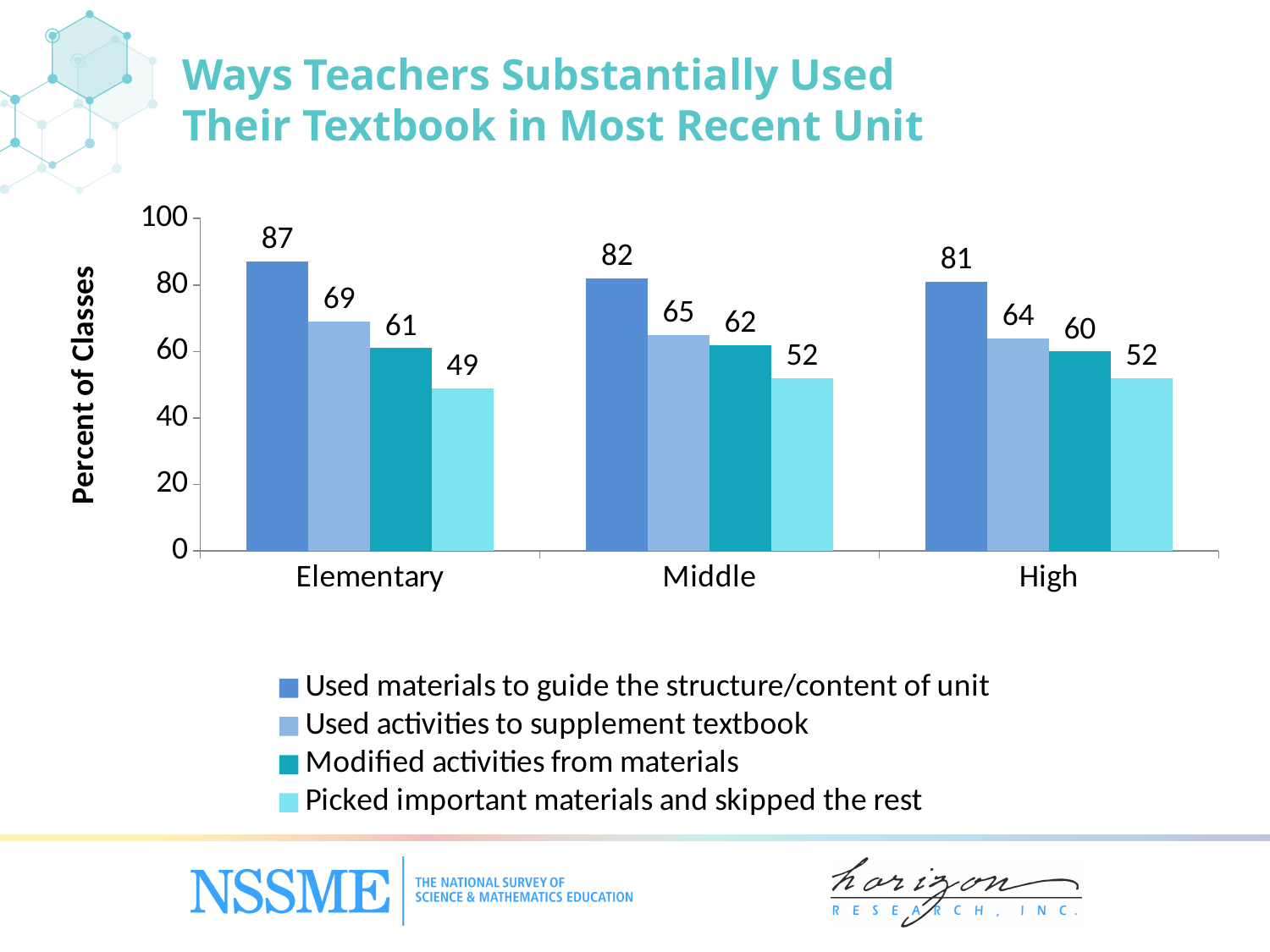
What is the difference between 'Used materials to guide the structure/content of unit' and 'Used activities to supplement textbook' for Middle classes? 17 What is the value for 'Modified activities from materials' for High classes? 60 How many grade-level categories are shown on the x axis? 3 Which is larger for High classes: 'Used activities to supplement textbook' or 'Modified activities from materials'? Used activities to supplement textbook How many series does the legend list? 4 What is the value for 'Picked important materials and skipped the rest' for Middle classes? 52 Which series has the lowest value for Elementary classes? Picked important materials and skipped the rest Which grade level has the highest value for 'Used materials to guide the structure/content of unit'? Elementary What is the label of the y axis? Percent of Classes What is the value for 'Used materials to guide the structure/content of unit' for Elementary classes? 87 Is the value for 'Picked important materials and skipped the rest' for Elementary classes greater or less than 60? less What kind of chart is shown on the slide? Bar chart